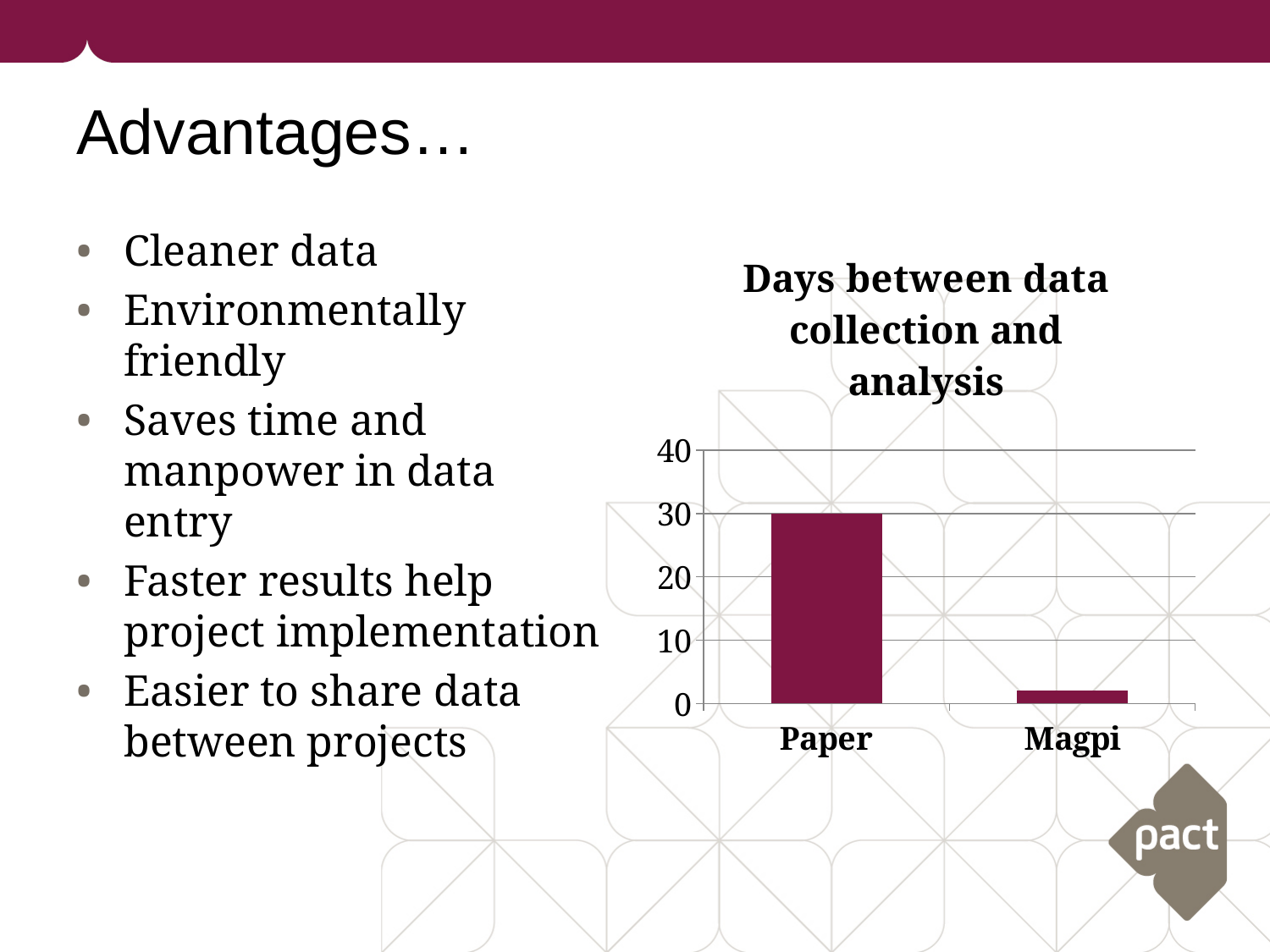
How many categories are plotted in the chart? 2 Is the value for Paper greater or less than 20? greater Is the value for Magpi greater or less than 10? less Which category has the highest value in the chart? Paper What kind of chart is shown on the slide? bar chart Which has a larger value, Paper or Magpi? Paper What is the highest value shown on the vertical axis of the chart? 40 What is the title of the chart? Days between data collection and analysis Which category has the lowest value in the chart? Magpi What is the value for Paper in the chart? 30